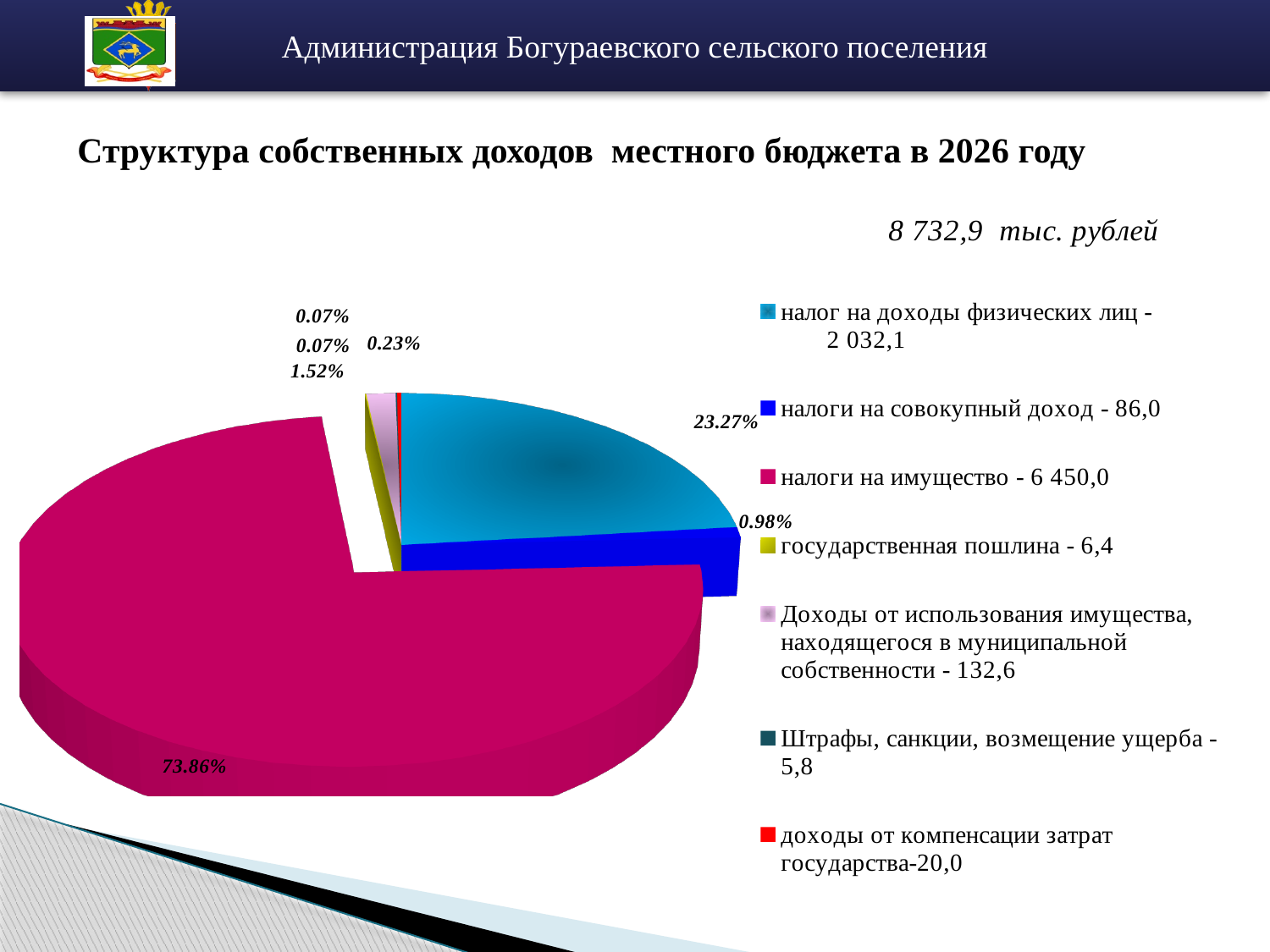
How many categories does the legend of the pie chart list? 7 What value is given in the legend for Доходы от использования имущества, находящегося в муниципальной собственности? 132,6 What is the difference between the values for налоги на имущество and налог на доходы физических лиц? 4 417,9 What value is given in the legend for налоги на имущество? 6 450,0 Which category has the largest share of the pie? налоги на имущество What percentage share is labelled for налог на доходы физических лиц? 23.27% What total amount (in тыс. рублей) is shown above the chart? 8 732,9 Which is larger: налоги на совокупный доход or доходы от компенсации затрат государства? налоги на совокупный доход Which category has the smallest value according to the legend? Штрафы, санкции, возмещение ущерба What kind of chart is shown on the slide? pie chart What value is given in the legend for налог на доходы физических лиц? 2 032,1 What percentage share is labelled for the largest slice (налоги на имущество)? 73.86%